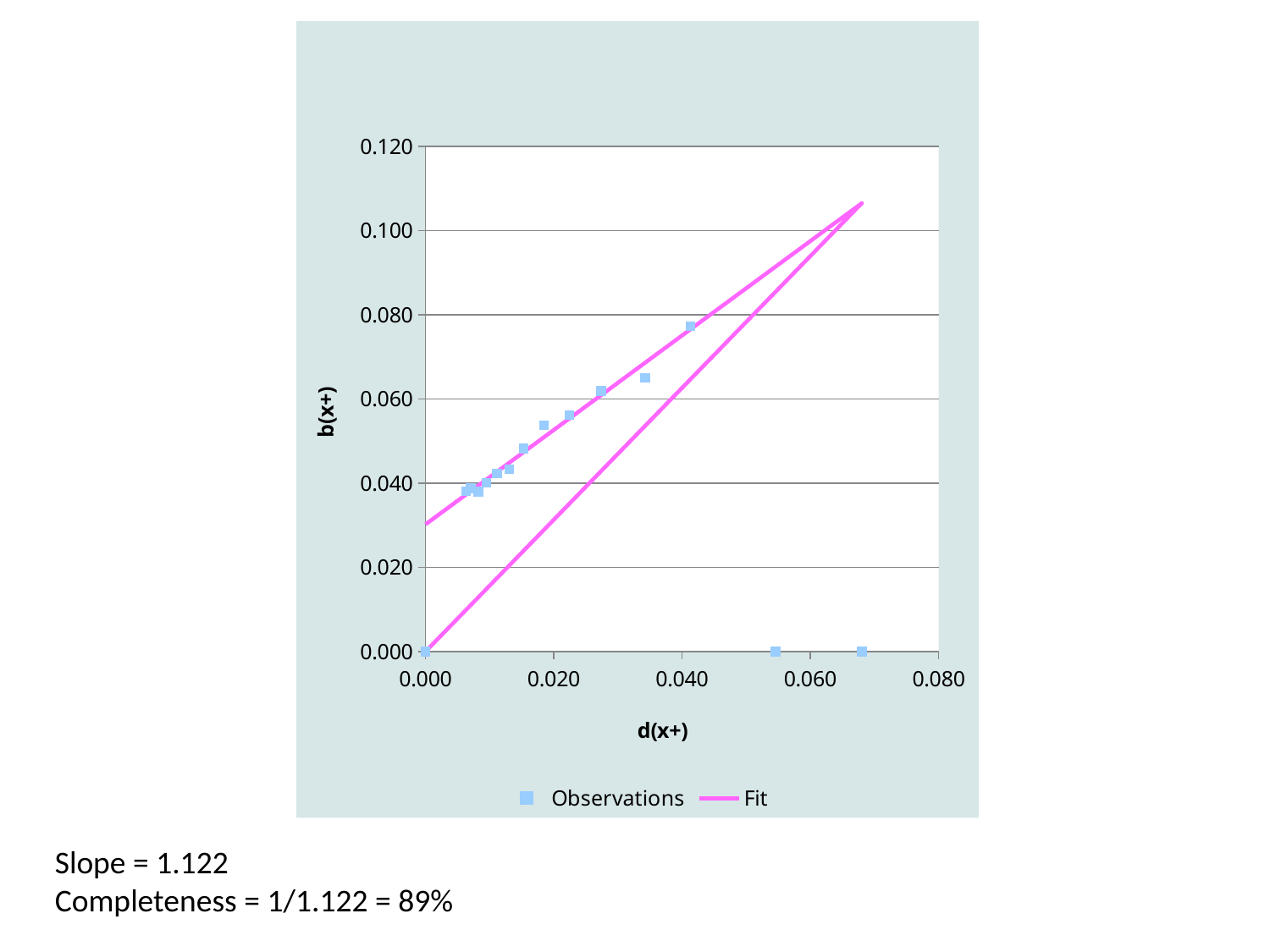
Is the b(x+) value of the observation near d(x+) = 0.027 greater or less than 0.080? less What are the two series named in the chart legend? Observations and Fit Do the observations between d(x+) = 0.000 and d(x+) = 0.040 generally rise or fall as d(x+) increases? rise Is the b(x+) value of the observation near d(x+) = 0.040 greater or less than 0.060? greater What slope value is stated on the slide for the fit? 1.122 Is the b(x+) value of the observation near d(x+) = 0.068 greater or less than 0.020? less What is the highest tick value shown on the x axis? 0.080 What is the highest tick value shown on the y axis? 0.120 What completeness value is stated on the slide? 89% What is the title of the x axis of the chart? d(x+) How many series does the chart legend list? 2 What kind of chart is shown on the slide? scatter chart